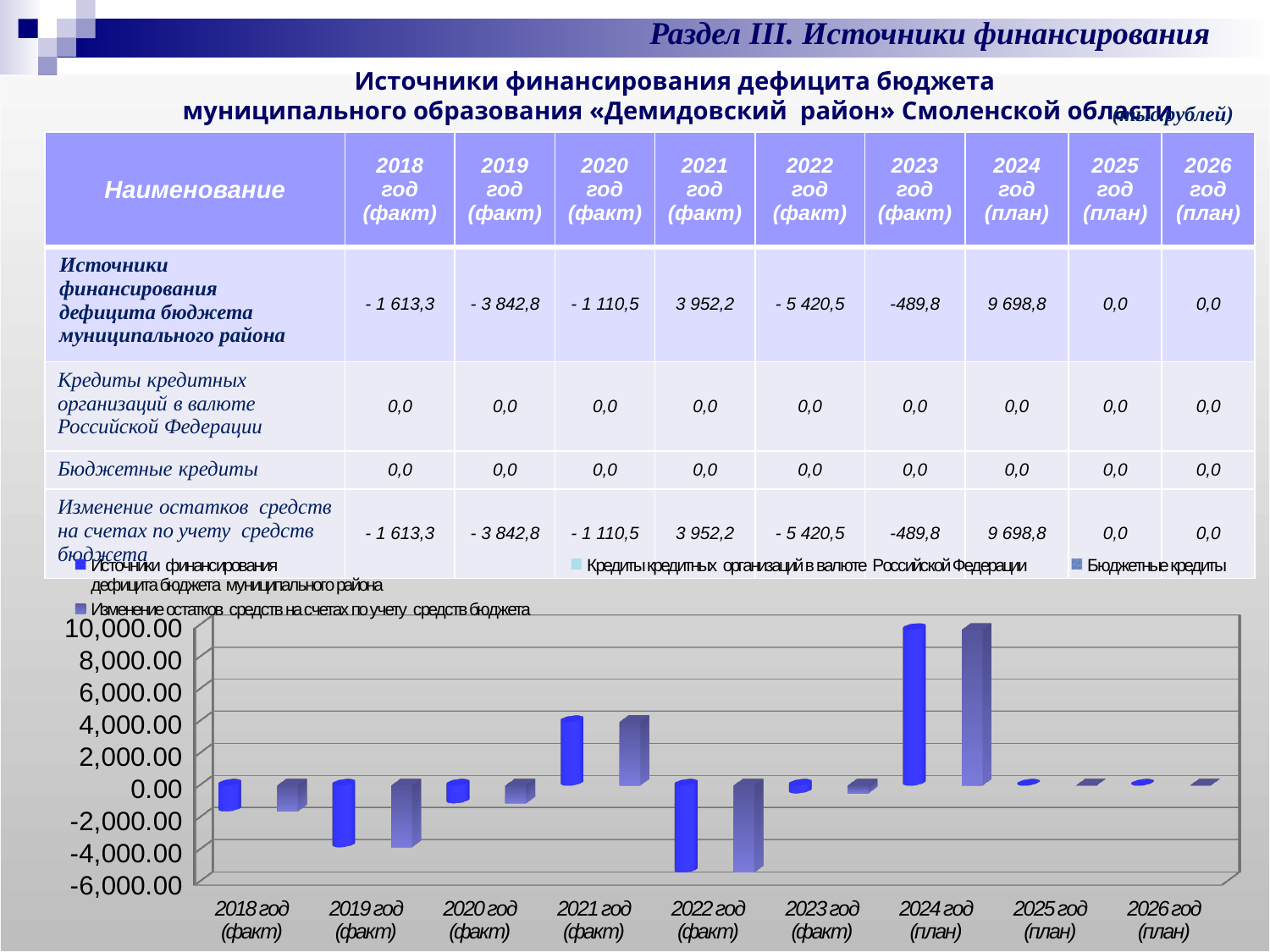
What is the lowest tick value shown on the chart's vertical axis? -6,000.00 For Источники финансирования дефицита бюджета муниципального района, which is larger: the value for 2019 год (факт) or for 2020 год (факт)? 2020 год (факт) In the chart, is the value for 2022 год (факт) for Источники финансирования дефицита бюджета муниципального района greater or less than -4,000.00? less What kind of chart is shown at the bottom of the slide? bar chart In the chart, is the value for 2021 год (факт) for Источники финансирования дефицита бюджета муниципального района greater or less than 2,000.00? greater Which year has the lowest value for Источники финансирования дефицита бюджета муниципального района in the chart? 2022 год (факт) What is the value of Источники финансирования дефицита бюджета муниципального района for 2024 год (план)? 9 698,8 Between 2021 год (факт) and 2022 год (факт), does the value for Источники финансирования дефицита бюджета муниципального района rise or fall? fall How many series does the chart legend list? 4 In the chart, is the value for 2024 год (план) for Источники финансирования дефицита бюджета муниципального района greater or less than 8,000.00? greater How many year categories are shown along the x axis of the chart? 9 Which year has the highest value for Источники финансирования дефицита бюджета муниципального района in the chart? 2024 год (план)